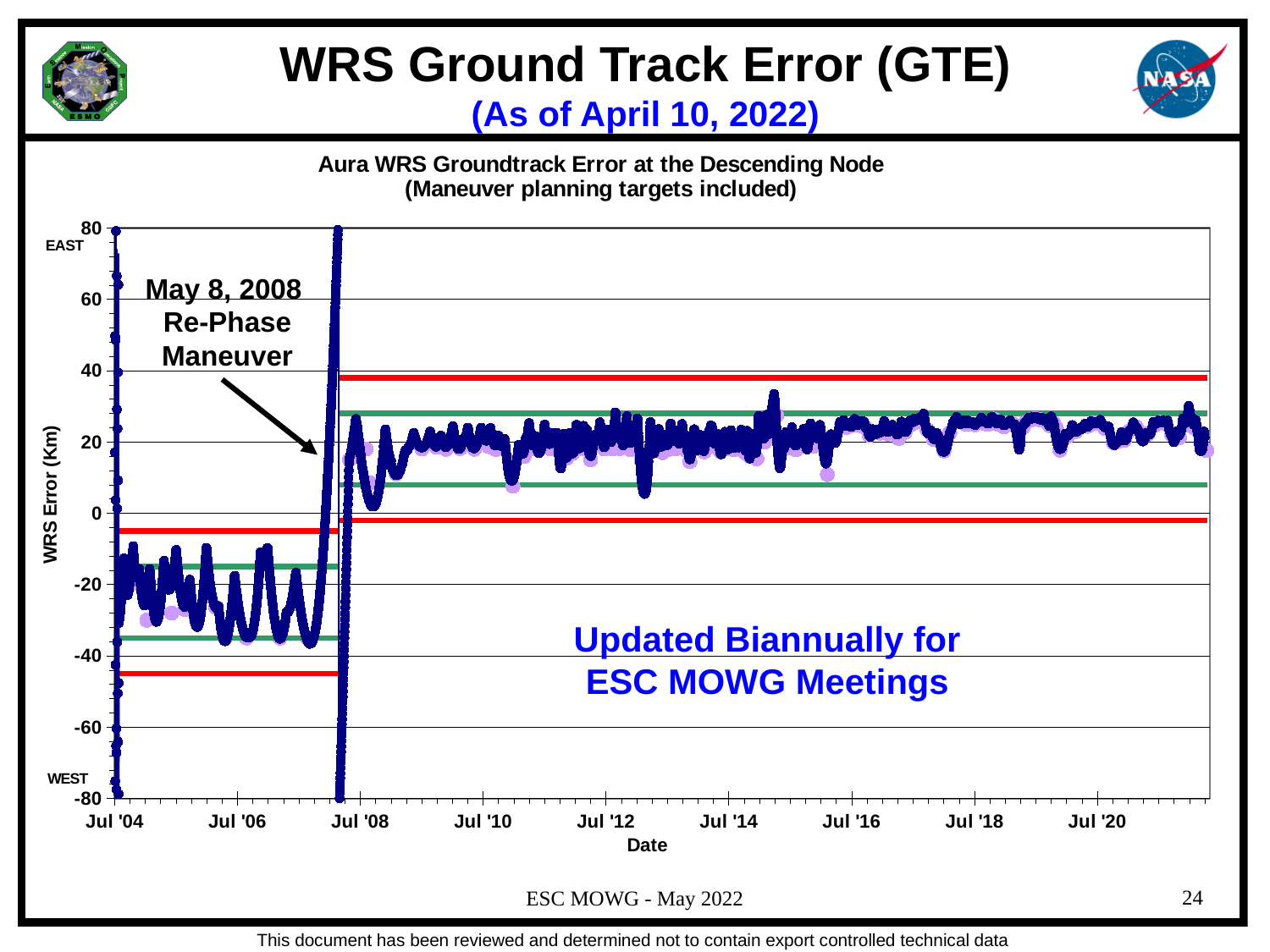
Is the plotted WRS error around Jul '10 greater or less than 0? greater What is the label of the y-axis? WRS Error (Km) What are the minimum and maximum values shown on the y-axis? -80 and 80 After the May 8, 2008 Re-Phase Maneuver, were the plotted values mostly above or below 0? above What is the title of the chart? Aura WRS Groundtrack Error at the Descending Node (Maneuver planning targets included) Is the plotted WRS error around Jul '18 greater or less than -20? greater Is the plotted WRS error around Jul '14 greater or less than 0? greater Before the May 8, 2008 Re-Phase Maneuver, were the plotted values mostly above or below 0? below What kind of chart is shown on the slide? line chart How many labelled tick marks are on the x-axis (Date)? 9